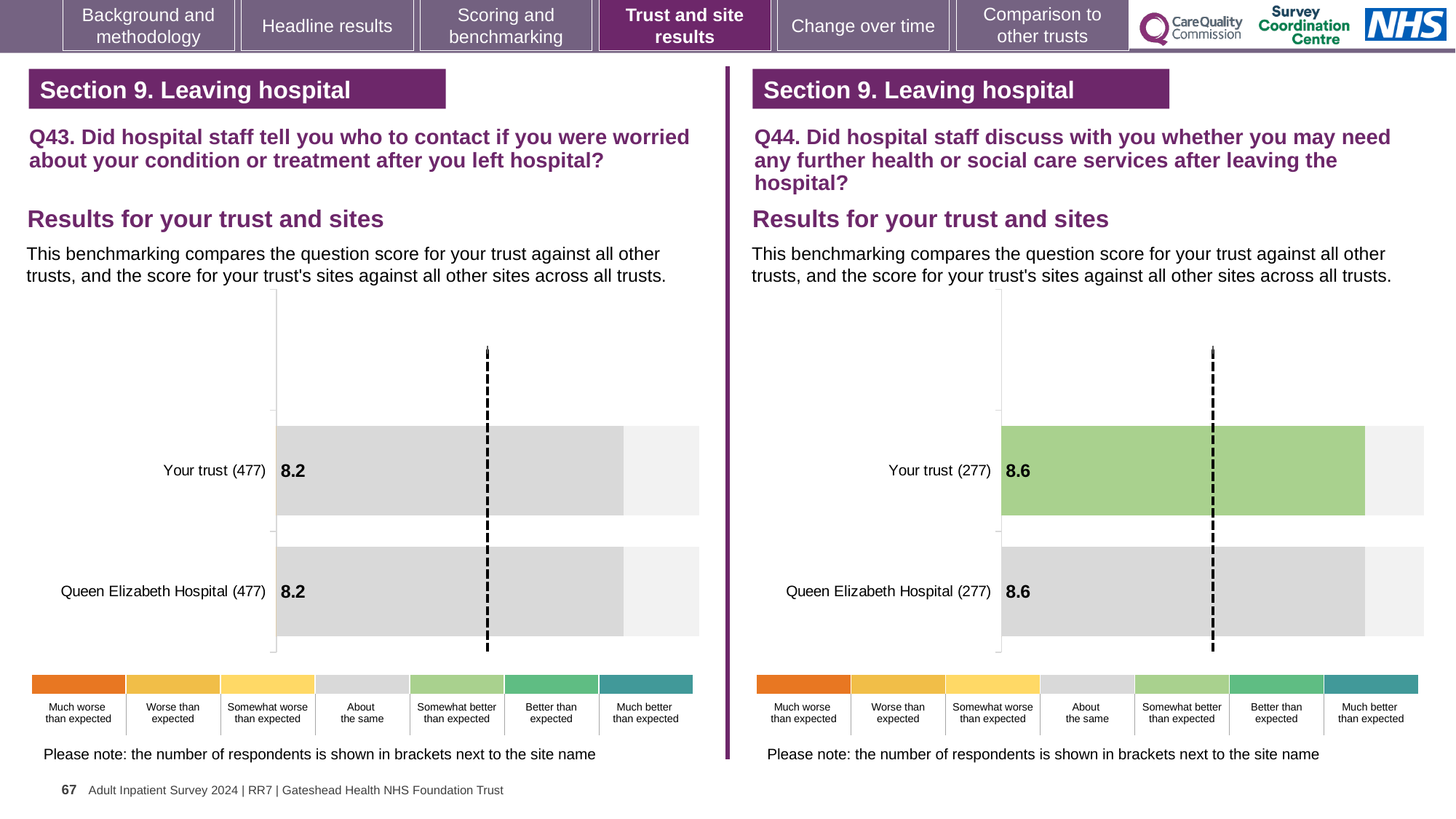
How many bars are plotted in the Q44 chart on the right? 2 In the Q44 chart on the right, what is the score for Your trust? 8.6 In the Q44 chart on the right, how many respondents are shown in brackets for Queen Elizabeth Hospital? 277 In the Q43 chart on the left, what is the score for Your trust? 8.2 In the Q44 chart on the right, which benchmark category does the colour of the Your trust bar correspond to? Somewhat better than expected What kind of chart is used for the Q43 results on the left? Bar chart In the Q43 chart on the left, how many respondents are shown in brackets for Your trust? 477 In the Q44 chart on the right, what is the score for Queen Elizabeth Hospital? 8.6 In the Q44 chart on the right, what is the difference between the score for Your trust and the score for Queen Elizabeth Hospital? 0.0 How many categories does the colour key below the Q43 chart on the left list? 7 In the Q43 chart on the left, what is the score for Queen Elizabeth Hospital? 8.2 How many bars are plotted in the Q43 chart on the left? 2